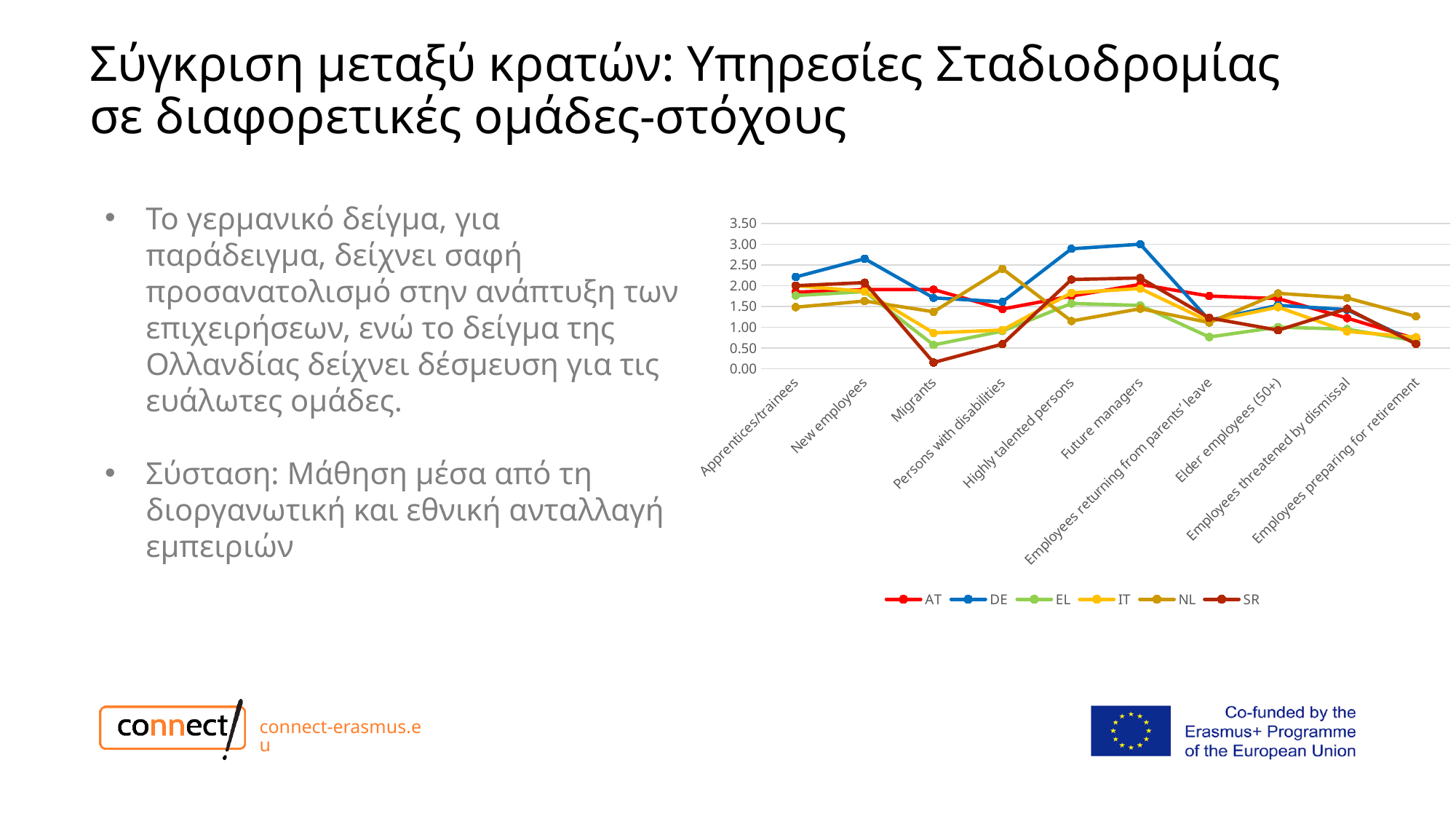
How many target-group categories are shown on the x axis? 10 Is the value for NL at Persons with disabilities greater or less than 2.00? greater How many series does the legend list? 6 Is the value for DE at Highly talented persons greater or less than 2.50? greater Which series has the highest value for Future managers? DE For Migrants, which is larger: the value for DE or the value for SR? DE Which series has the lowest value for Employees returning from parents' leave? EL Does the DE line rise or fall from Future managers to Employees returning from parents' leave? fall What kind of chart is shown on the slide? line chart Which series has the lowest value for Migrants? SR Is the value for SR at Migrants greater or less than 0.50? less Which series has the highest value for Persons with disabilities? NL